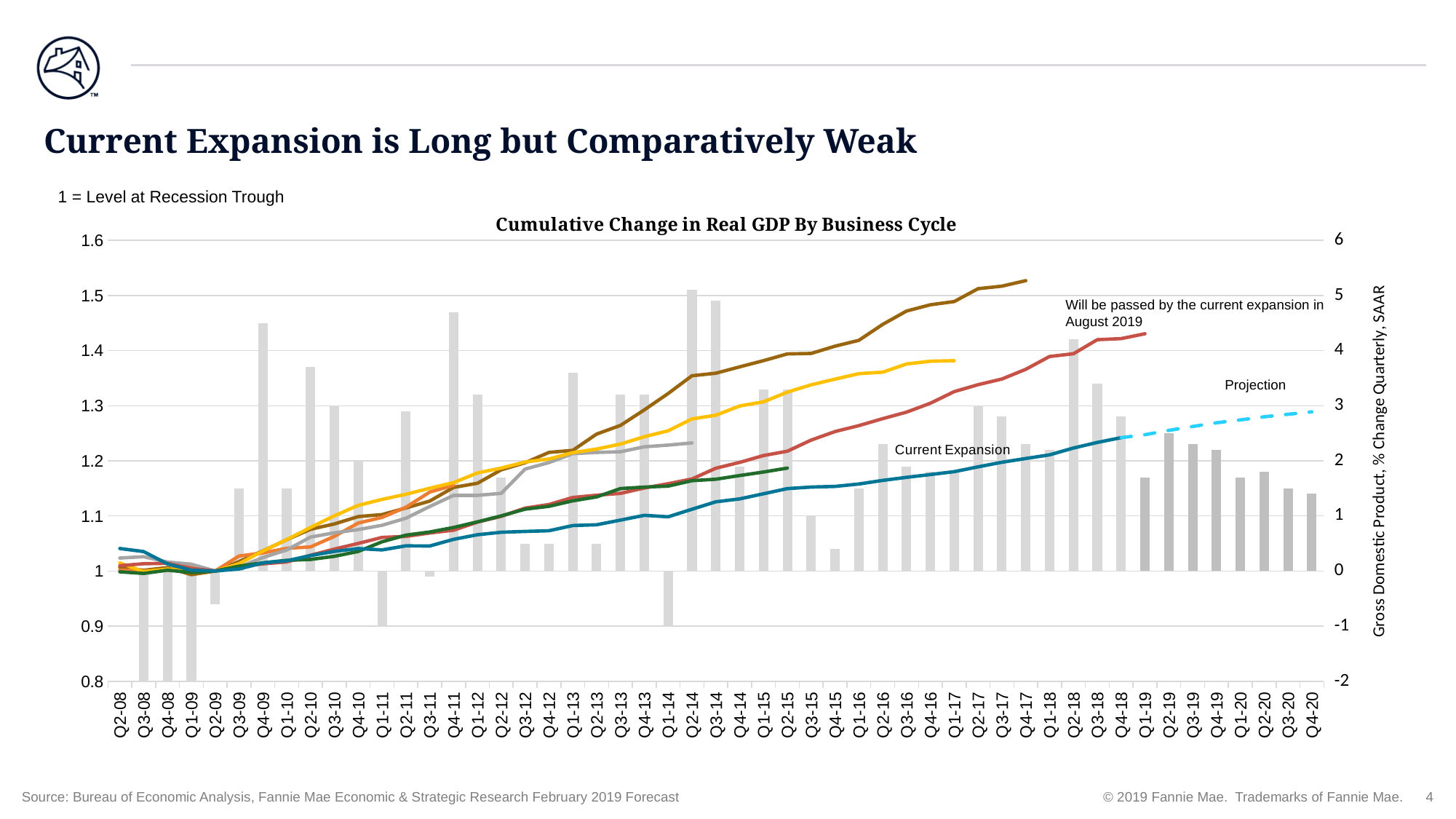
What kind of chart is shown on the slide? A combination chart of bars and lines Is the endpoint of the brown line at Q4-17 greater or less than 1.5 on the left-hand axis? greater Is the bar for Q1-09 greater or less than -1 on the right-hand axis? less Is the endpoint of the yellow line at Q1-17 greater or less than 1.4 on the left-hand axis? less What is the label of the right-hand vertical axis? Gross Domestic Product, % Change Quarterly, SAAR Which line reaches the highest level on the left-hand axis? The brown line What is the title of the chart? Cumulative Change in Real GDP By Business Cycle Does the Current Expansion line rise or fall from Q2-09 to Q4-18? rise